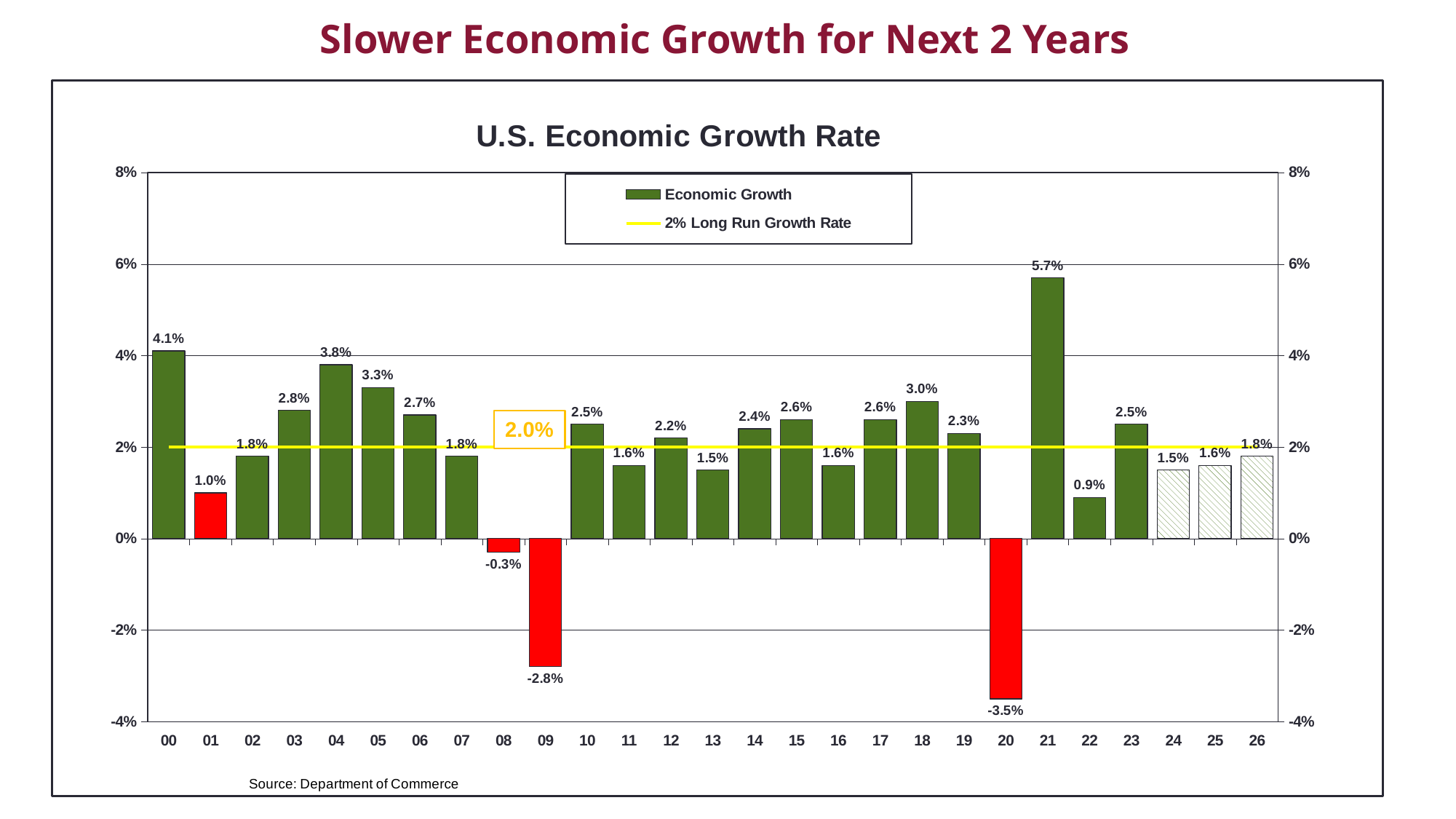
What is the economic growth rate shown for 21? 5.7% What kind of chart is this? bar chart What is the economic growth rate shown for 26? 1.8% What value does the yellow horizontal line represent? 2.0% Which year has the highest economic growth rate? 21 Which year has the lowest economic growth rate? 20 How many years are shown on the x axis? 27 What is the title of the chart? U.S. Economic Growth Rate How many entries does the legend list? 2 What is the difference between the growth rate in 00 and the growth rate in 01? 3.1% Which year has a higher growth rate, 04 or 05? 04 What is the economic growth rate shown for 09? -2.8%